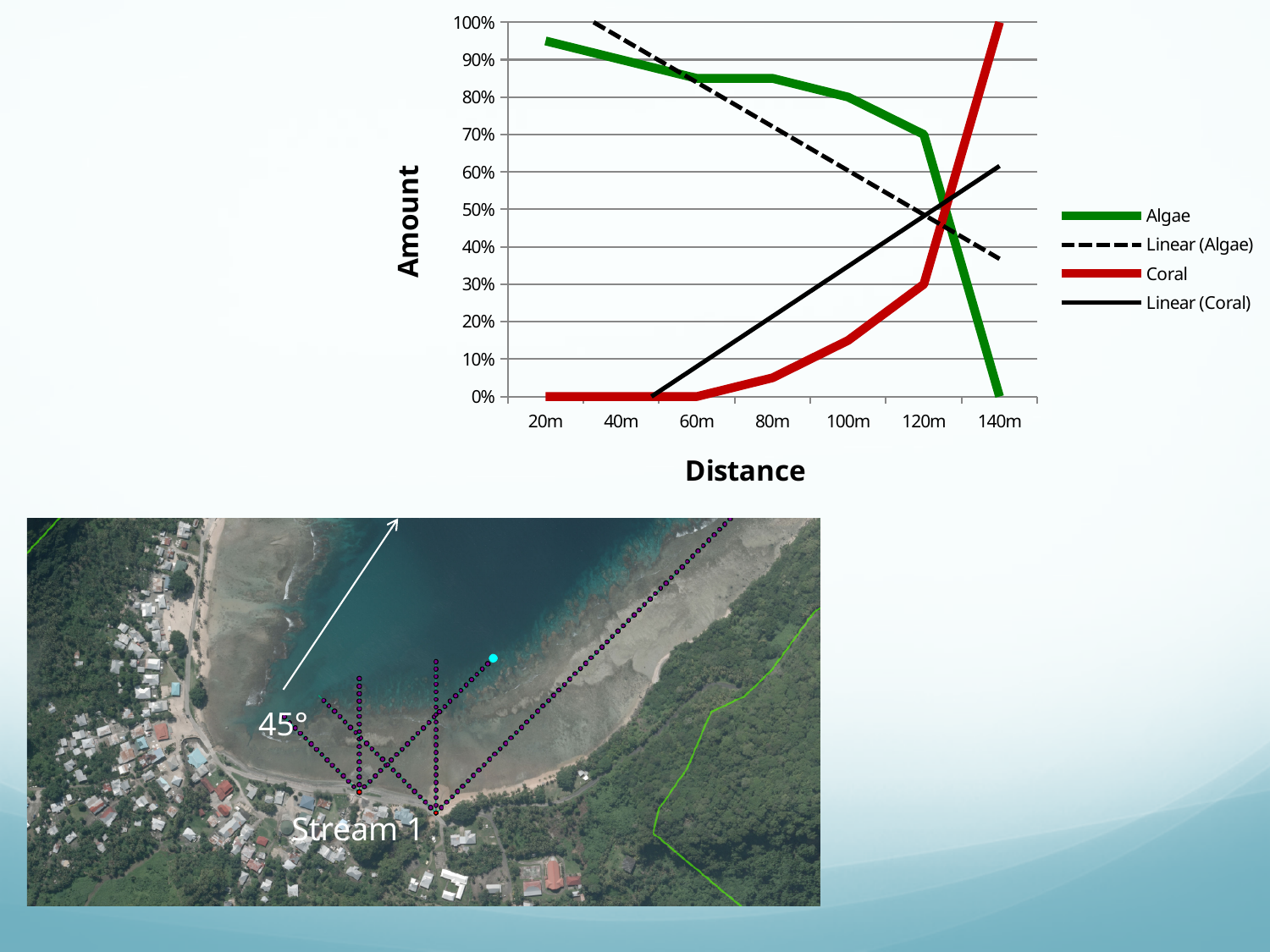
Does the Coral series rise or fall as distance increases from 20m to 140m? Rises What kind of chart is shown on the slide? Line chart At which distance is the Algae value highest? 20m Is the Algae value at 20m greater or less than 90%? greater What is the Coral value at 20m? 0% How many distance categories are shown on the x axis of the chart? 7 Is the Coral value at 100m greater or less than 20%? less How many entries does the chart legend list? 4 At 100m, which series has the larger value, Algae or Coral? Algae What is the Coral value at 140m? 100% At which distance is the Coral value lowest, among 80m, 100m, 120m and 140m? 80m What is the Algae value at 140m? 0%